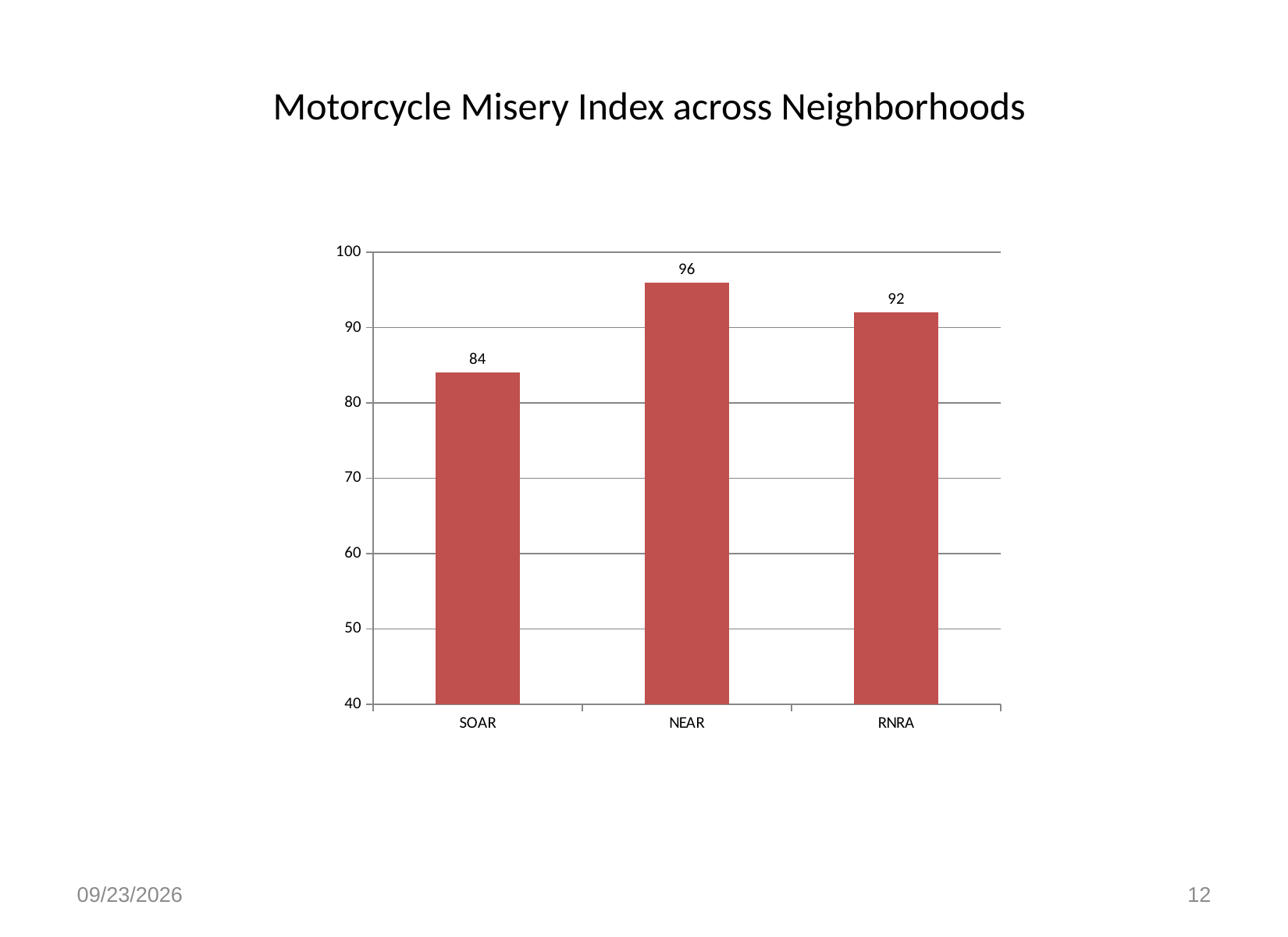
Which neighborhood has the highest Motorcycle Misery Index? NEAR How many neighborhoods are shown on the chart? 3 Which has a larger value, RNRA or SOAR? RNRA Which neighborhood has the lowest Motorcycle Misery Index? SOAR What is the Motorcycle Misery Index value for RNRA? 92 What kind of chart is shown on the slide? bar chart What is the Motorcycle Misery Index value for NEAR? 96 Is the value for SOAR greater or less than 90? less What is the difference between the values for NEAR and RNRA? 4 What is the difference between the values for NEAR and SOAR? 12 What is the title of the chart? Motorcycle Misery Index across Neighborhoods What is the Motorcycle Misery Index value for SOAR? 84